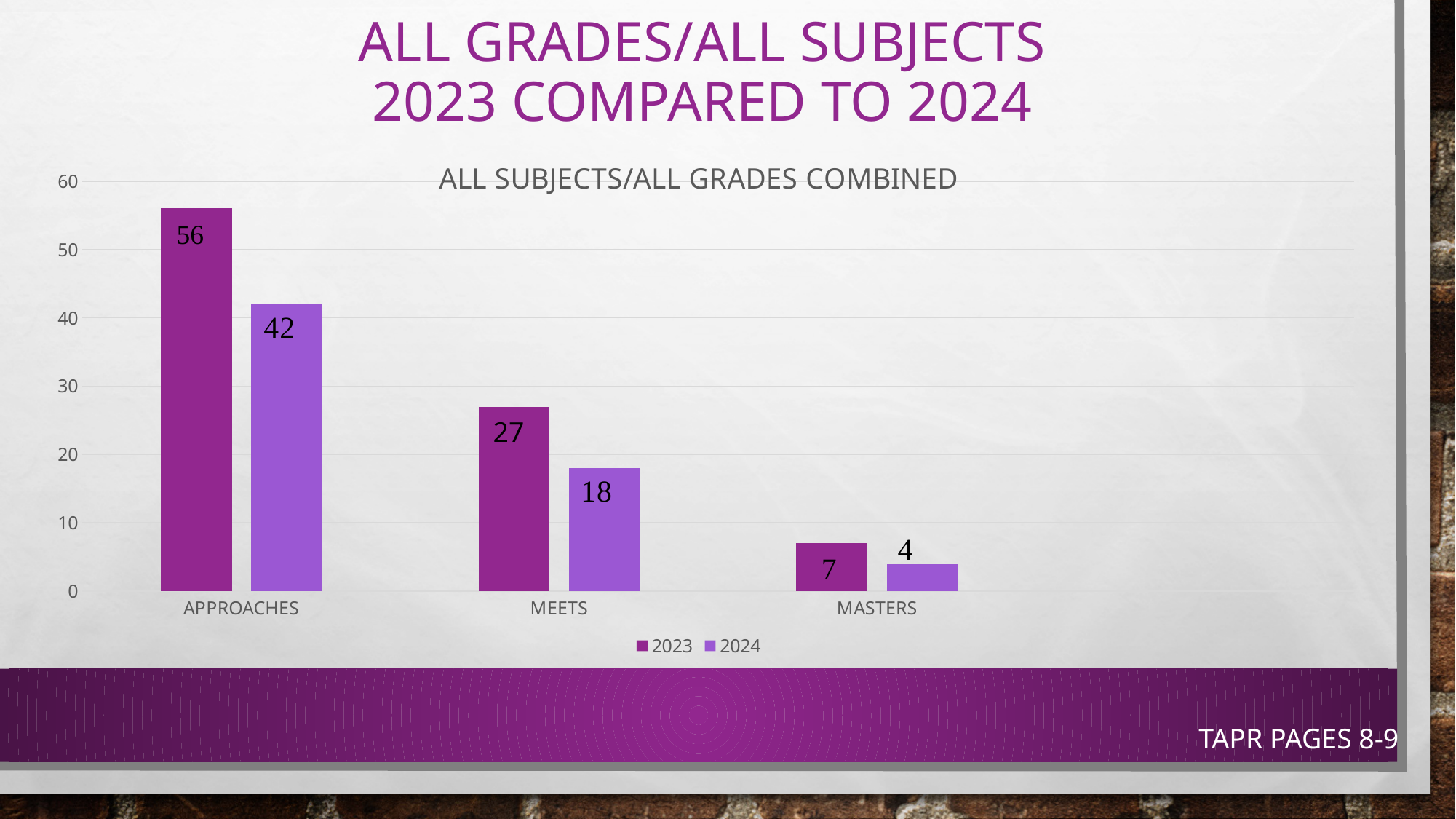
What is the difference between the 2023 and 2024 values for Approaches? 14 Which category has the lowest 2024 value? Masters What is the 2024 value for Meets? 18 What kind of chart is shown on the slide? Bar chart How many series does the legend list? 2 What is the 2023 value for Approaches? 56 Which category has the highest 2023 value? Approaches What is the 2024 value for Masters? 4 How many categories are shown on the x axis? 3 What is the difference between the 2023 and 2024 values for Meets? 9 What is the title of the chart? All Subjects/All Grades Combined Which is larger, the 2023 value for Masters or the 2024 value for Masters? 2023